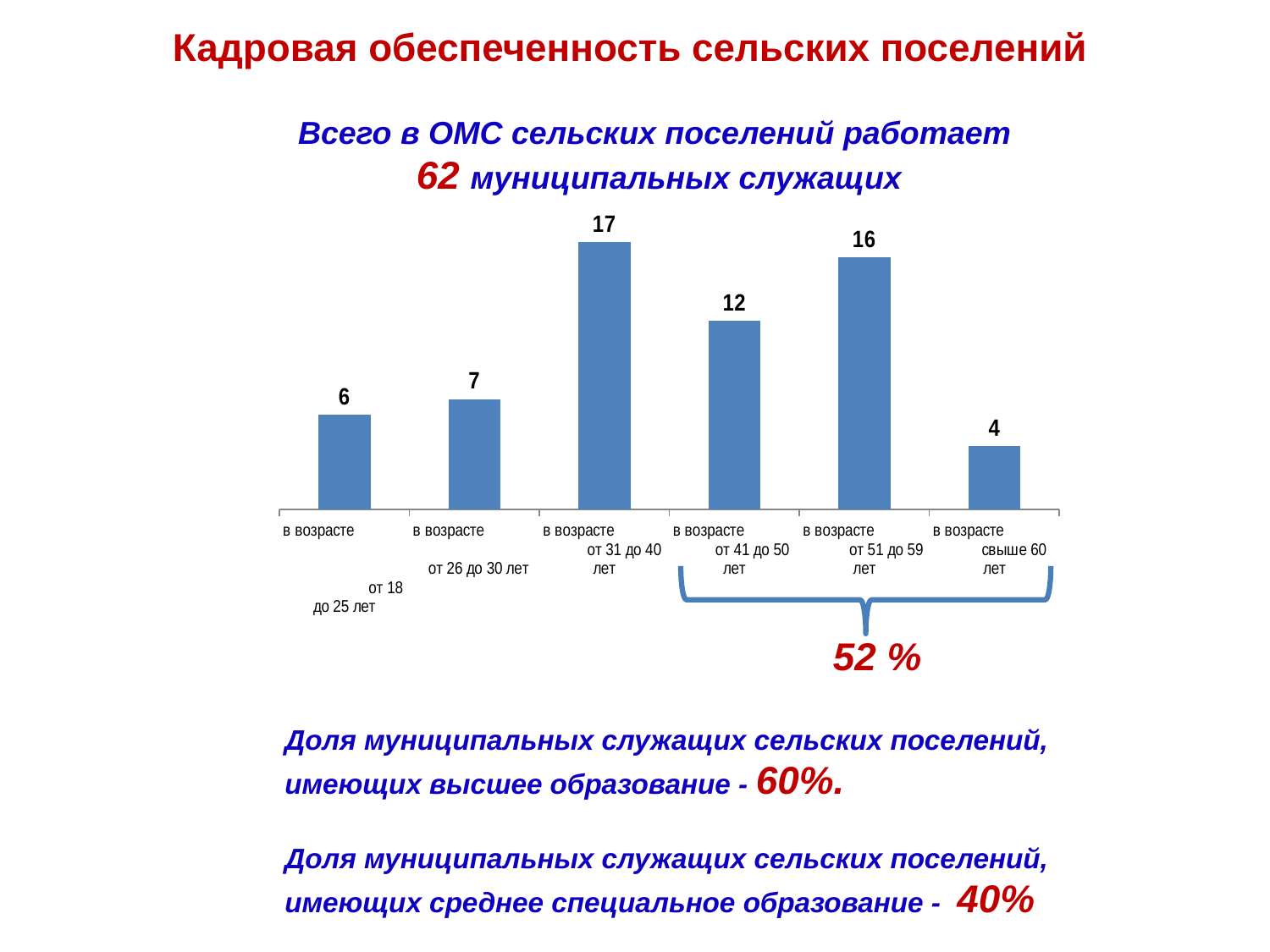
How many municipal employees are in the age group 'от 31 до 40 лет'? 17 Which age group has the highest value? в возрасте от 31 до 40 лет What is the value for the age group 'от 18 до 25 лет'? 6 How many age categories are shown in the chart? 6 What percentage is shown under the bracket grouping the three oldest age categories? 52 % What is the difference between the values for 'от 31 до 40 лет' and 'от 41 до 50 лет'? 5 What is the value for the age group 'свыше 60 лет'? 4 What is the total of the values for 'от 41 до 50 лет', 'от 51 до 59 лет' and 'свыше 60 лет'? 32 Which is larger: the value for 'от 26 до 30 лет' or the value for 'от 41 до 50 лет'? от 41 до 50 лет What type of chart is shown on the slide? bar chart What is the value for the age group 'от 51 до 59 лет'? 16 Which age group has the lowest value? в возрасте свыше 60 лет